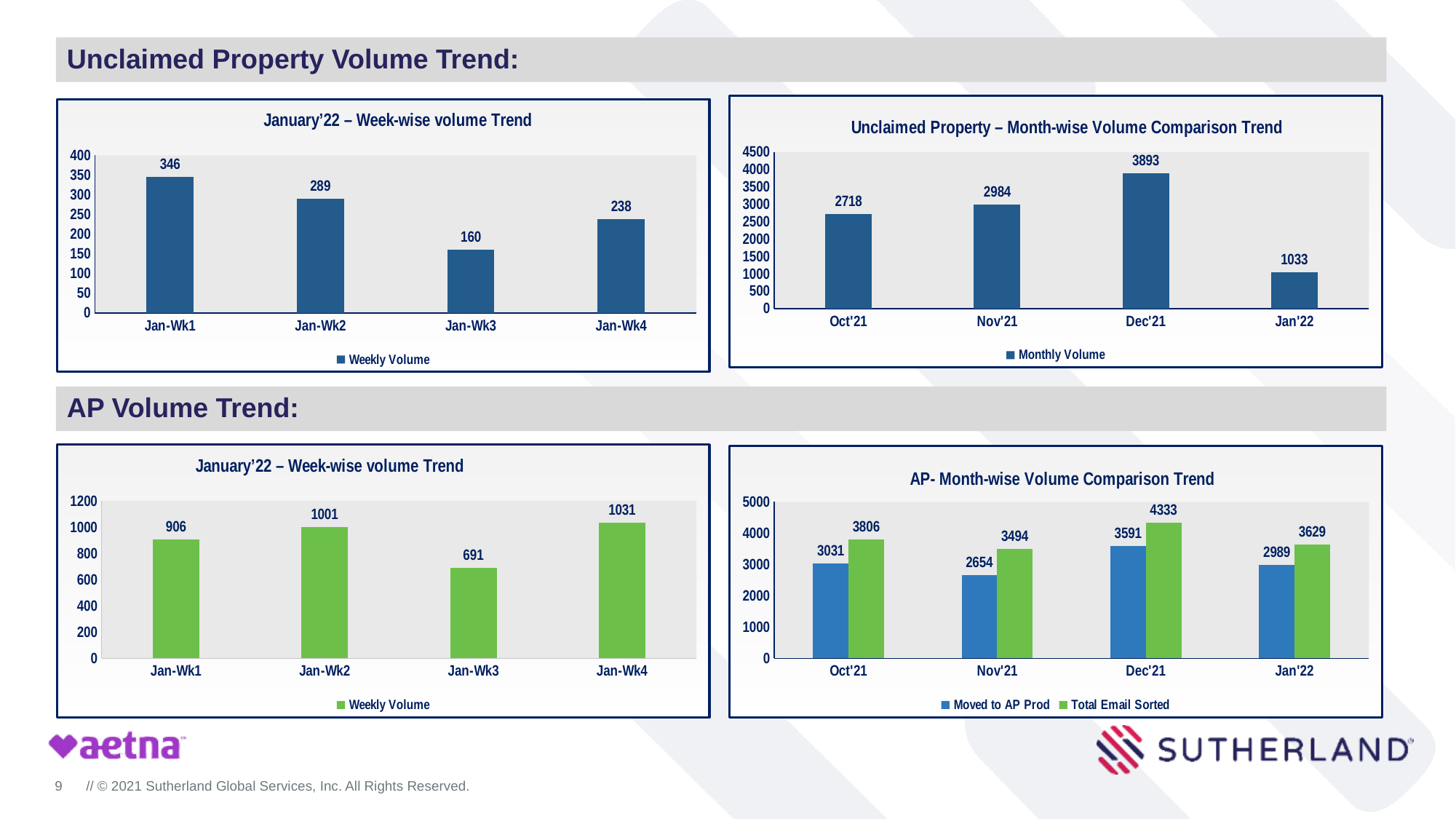
What kind of chart is the 'AP- Month-wise Volume Comparison Trend' chart? Bar chart In the top-left chart (Unclaimed Property, January'22 – Week-wise volume Trend), what is the difference between the Jan-Wk1 and Jan-Wk4 volumes? 108 In the bottom-left chart (AP Volume Trend, January'22 – Week-wise volume Trend), what is the weekly volume for Jan-Wk3? 691 In the 'AP- Month-wise Volume Comparison Trend' chart, what is the 'Total Email Sorted' value for Nov'21? 3494 In the top-left chart (Unclaimed Property, January'22 – Week-wise volume Trend), which week has the lowest weekly volume? Jan-Wk3 In the bottom-left chart (AP Volume Trend, January'22 – Week-wise volume Trend), which week has the highest weekly volume? Jan-Wk4 In the 'Unclaimed Property – Month-wise Volume Comparison Trend' chart, how many months are shown on the x axis? 4 In the 'AP- Month-wise Volume Comparison Trend' chart, how many series does the legend list? 2 In the 'Unclaimed Property – Month-wise Volume Comparison Trend' chart, what is the monthly volume for Dec'21? 3893 In the 'Unclaimed Property – Month-wise Volume Comparison Trend' chart, which month has the lowest monthly volume? Jan'22 In the 'AP- Month-wise Volume Comparison Trend' chart, what is the difference between 'Total Email Sorted' and 'Moved to AP Prod' for Dec'21? 742 In the top-left chart (Unclaimed Property, January'22 – Week-wise volume Trend), what is the weekly volume for Jan-Wk1? 346